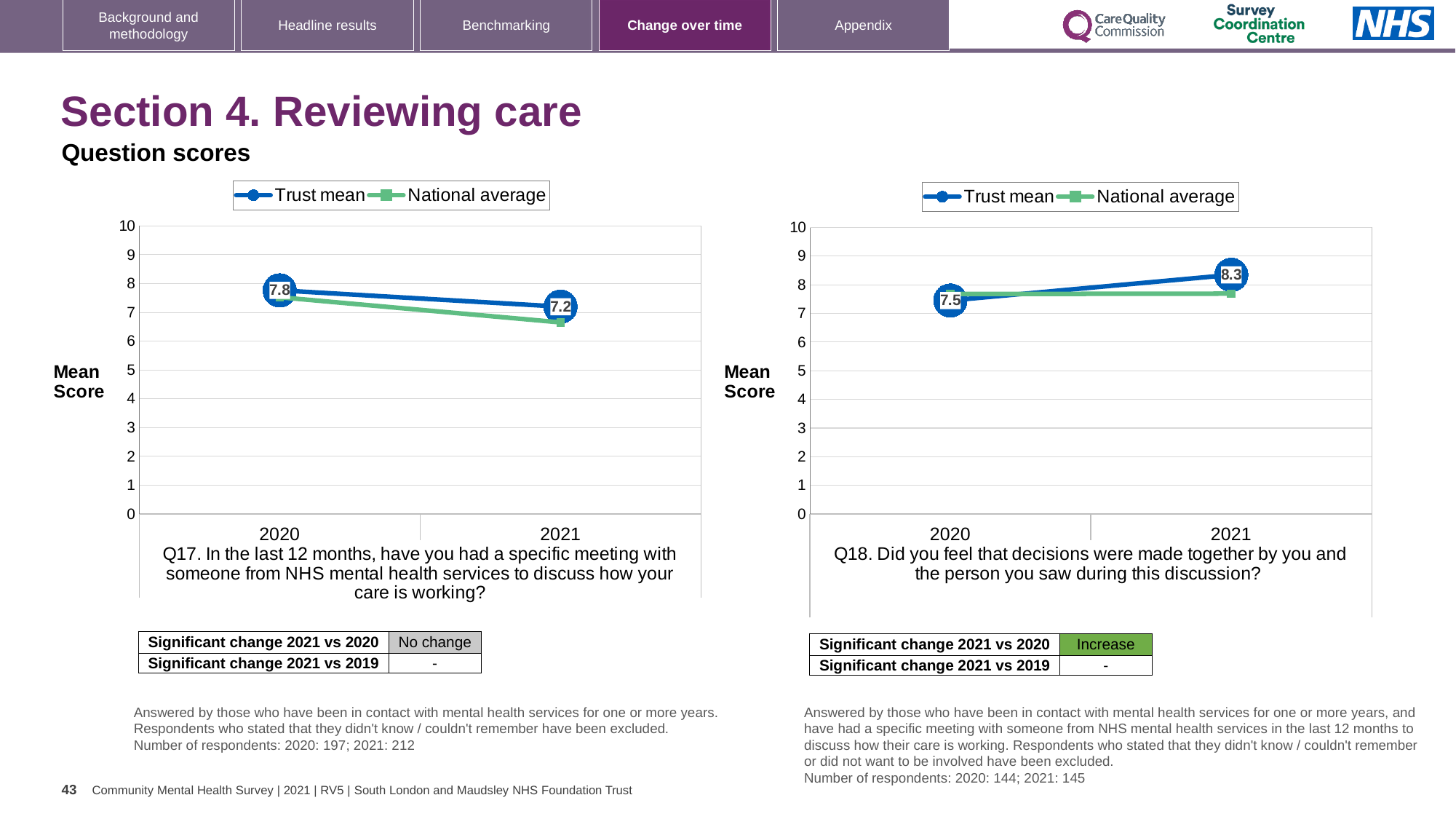
How many series does the legend of the Q18 chart on the right list? 2 In the Q17 chart on the left, what is the Trust mean score for 2021? 7.2 What kind of chart is the Q17 chart on the left? line chart In the Q17 chart on the left, by how much did the Trust mean fall from 2020 to 2021? 0.6 In the Q18 chart on the right, what is the Trust mean score for 2021? 8.3 In the Q17 chart on the left, what is the Trust mean score for 2020? 7.8 In the Q18 chart on the right, does the Trust mean rise or fall from 2020 to 2021? rise In the Q17 chart on the left, does the Trust mean rise or fall from 2020 to 2021? fall In the Q18 chart on the right, what is the Trust mean score for 2020? 7.5 In the Q18 chart on the right, by how much did the Trust mean rise from 2020 to 2021? 0.8 In the Q18 chart on the right, is the National average for 2020 greater or less than 7? greater In the Q17 chart on the left, is the National average for 2021 greater or less than 7? less